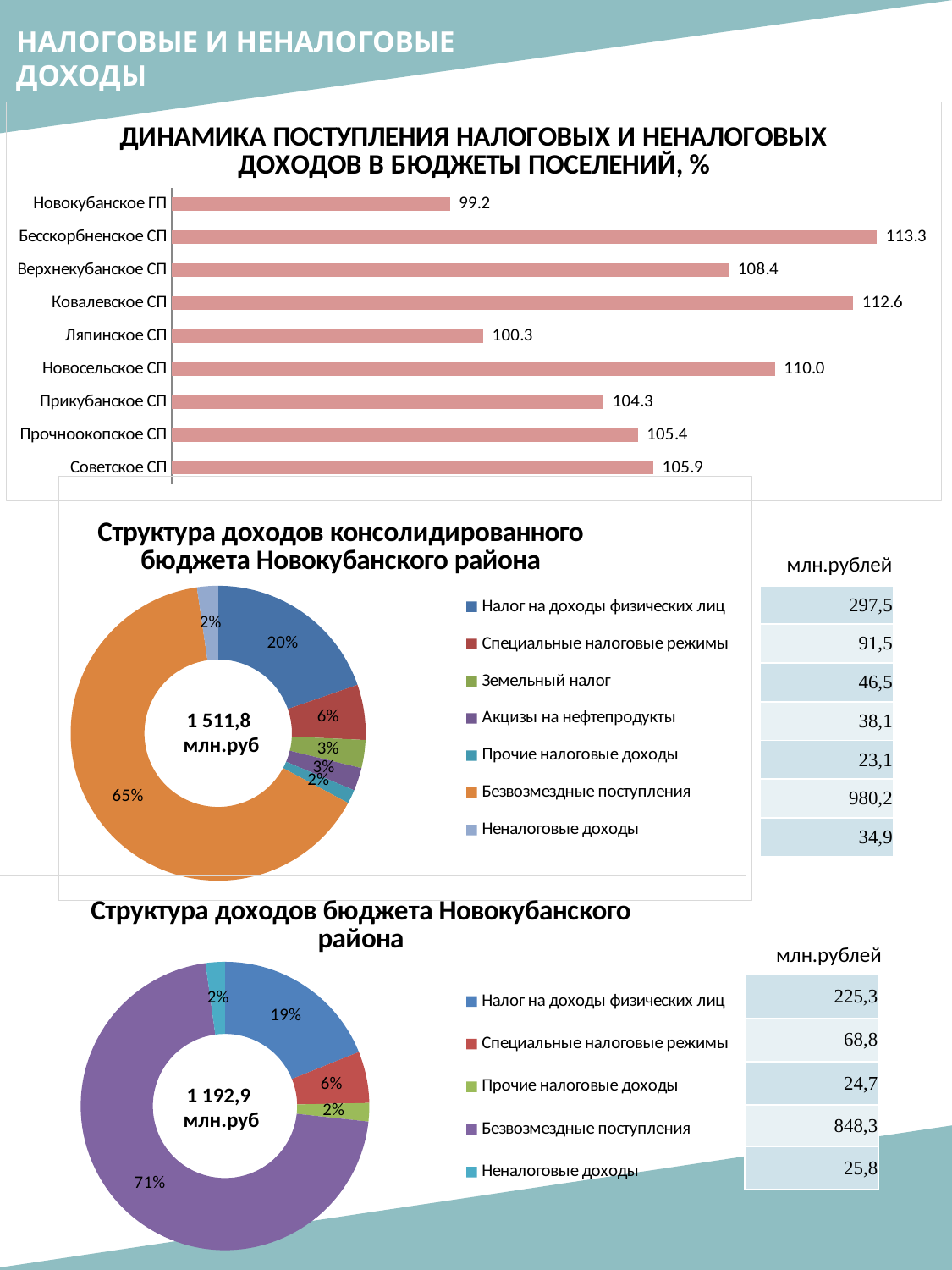
In the top bar chart, what is the difference between the values for Бесскорбненское СП and Новокубанское ГП? 14.1 In the bottom doughnut chart 'Структура доходов бюджета Новокубанского района', what share do Безвозмездные поступления make up? 71% In the top bar chart, which is larger: the value for Новосельское СП or the value for Прикубанское СП? Новосельское СП In the middle doughnut chart 'Структура доходов консолидированного бюджета Новокубанского района', how many series does the legend list? 7 In the top bar chart, which settlement has the highest value? Бесскорбненское СП In the top bar chart, which settlement has the lowest value? Новокубанское ГП What total in млн.руб is shown in the centre of the bottom doughnut chart 'Структура доходов бюджета Новокубанского района'? 1 192,9 In the table next to the middle doughnut chart, what is the value in млн.рублей for Налог на доходы физических лиц? 297,5 How many settlements are shown in the top bar chart? 9 In the top bar chart 'Динамика поступления налоговых и неналоговых доходов в бюджеты поселений, %', what is the value for Ковалевское СП? 112.6 In the middle doughnut chart 'Структура доходов консолидированного бюджета Новокубанского района', what share do Безвозмездные поступления make up? 65% What type of chart is the top chart on the slide? Bar chart